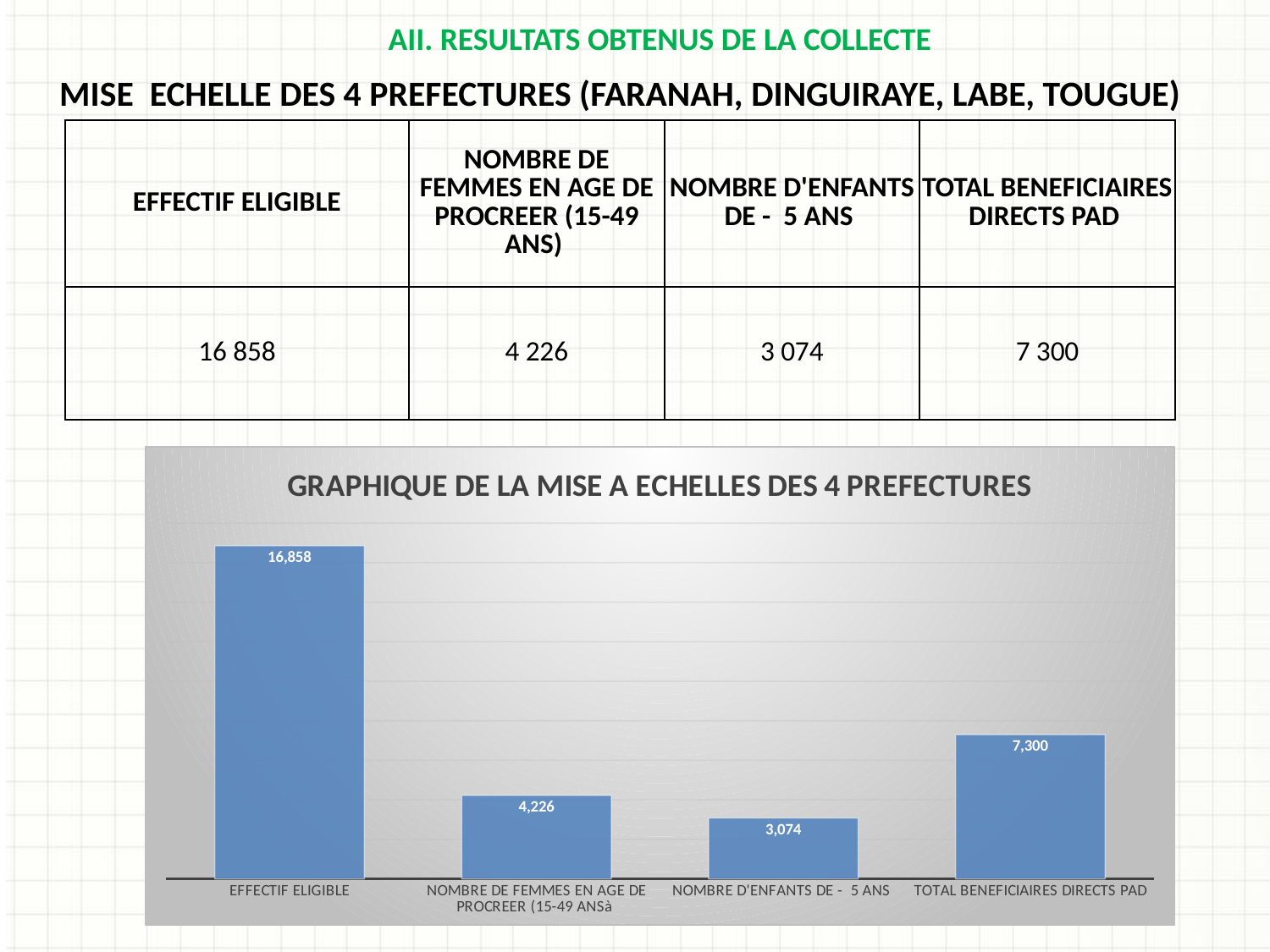
What is the value for TOTAL BENEFICIAIRES DIRECTS PAD in the chart? 7,300 What is the value for NOMBRE D'ENFANTS DE - 5 ANS in the chart? 3,074 Which category has the highest value in the chart? EFFECTIF ELIGIBLE What is the value for EFFECTIF ELIGIBLE in the chart? 16,858 What colour are the bars in the chart? Blue What is the difference between the values for EFFECTIF ELIGIBLE and TOTAL BENEFICIAIRES DIRECTS PAD? 9,558 Which is larger: the value for NOMBRE DE FEMMES EN AGE DE PROCREER (15-49 ANS) or the value for TOTAL BENEFICIAIRES DIRECTS PAD? TOTAL BENEFICIAIRES DIRECTS PAD What is the title of the chart? GRAPHIQUE DE LA MISE A ECHELLES DES 4 PREFECTURES What is the difference between the values for NOMBRE DE FEMMES EN AGE DE PROCREER (15-49 ANS) and NOMBRE D'ENFANTS DE - 5 ANS? 1,152 How many categories are shown in the chart? 4 Which category has the lowest value in the chart? NOMBRE D'ENFANTS DE - 5 ANS What kind of chart is shown on the slide? Bar chart